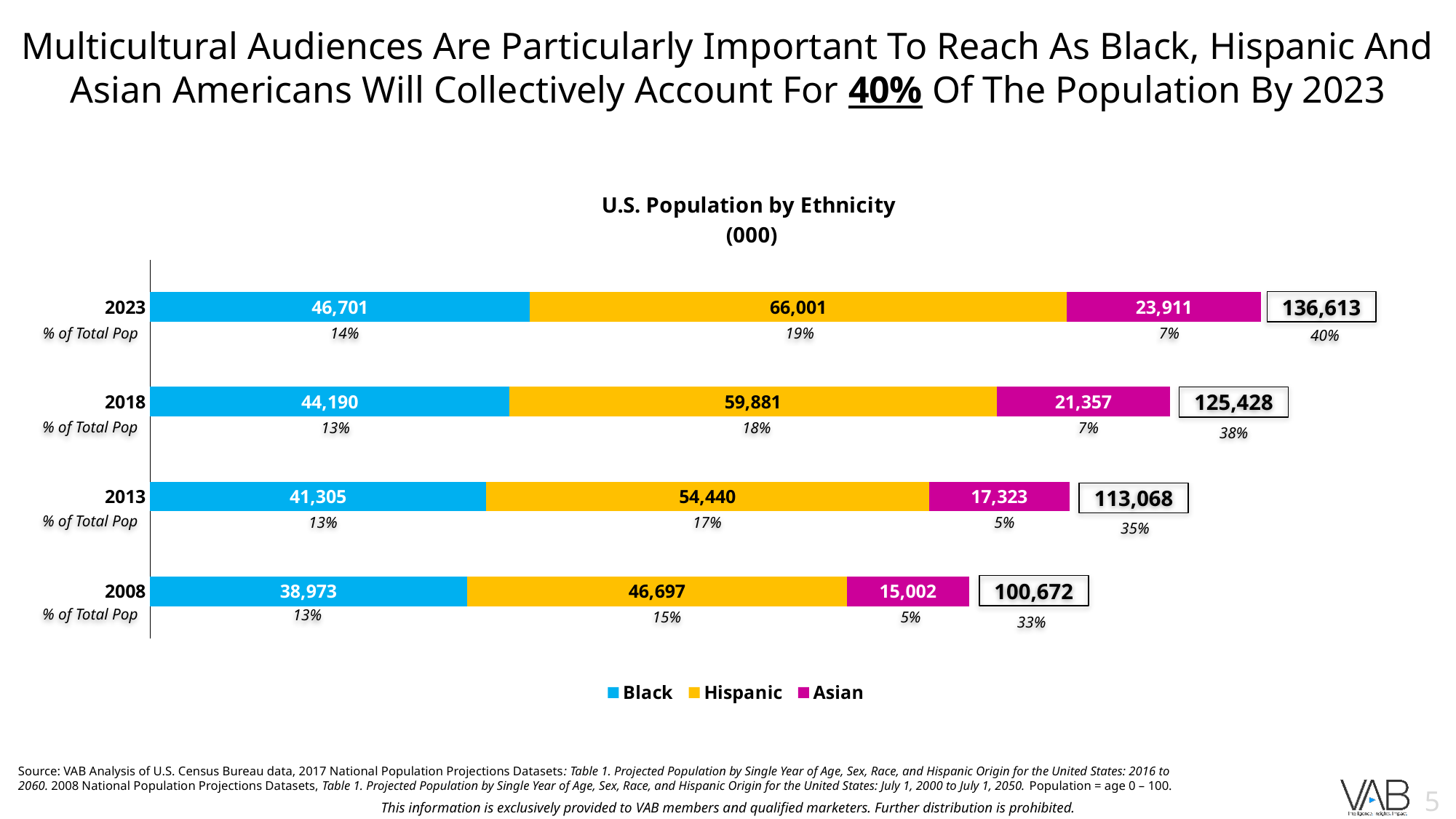
Which is larger, the Black value for 2013 or the Hispanic value for 2008? Hispanic value for 2008 What is the Black population value for 2008? 38,973 What is the total shown for the 2018 bar? 125,428 Which year has the highest total multicultural population? 2023 What is the Asian population value for 2013? 17,323 What is the Hispanic population value for 2023? 66,001 How many series does the legend list? 3 How many years are shown on the chart? 4 What percent of the total population does the Hispanic segment represent in 2023? 19% What kind of chart is shown? Stacked bar chart What is the difference between the Hispanic values for 2023 and 2018? 6,120 Which year has the lowest Asian population value? 2008